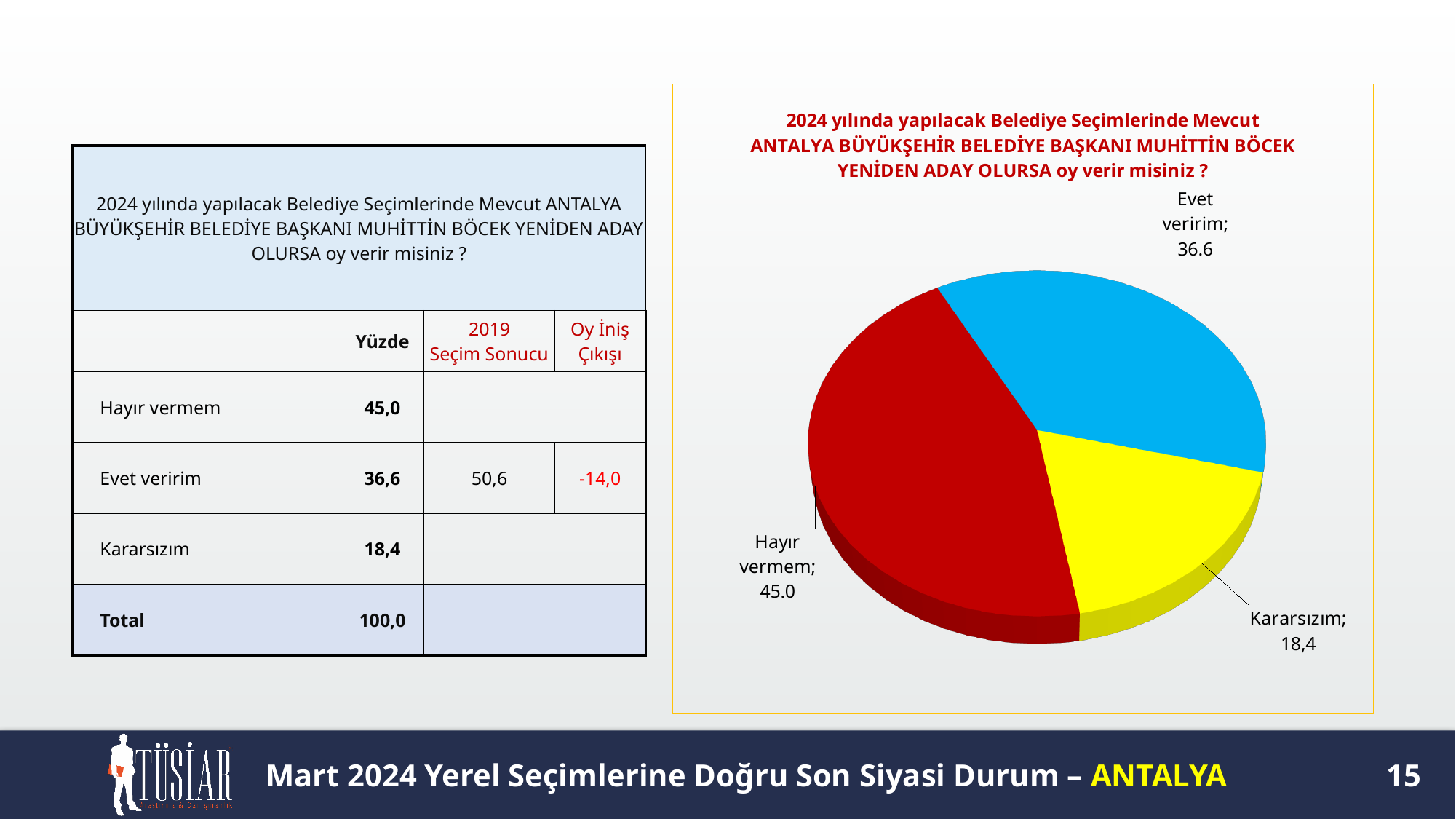
What kind of chart is shown on the slide? pie chart Which slice of the pie chart is the smallest? Kararsızım Which slice of the pie chart is the largest? Hayır vermem Which is larger in the pie chart, 'Evet veririm' or 'Hayır vermem'? Hayır vermem What is the value shown for the 'Evet veririm' slice in the pie chart? 36.6 What is the difference between the 'Hayır vermem' and 'Evet veririm' values in the pie chart? 8.4 What colour is the 'Hayır vermem' slice in the pie chart? red What is the value shown for the 'Kararsızım' slice in the pie chart? 18,4 Which is larger in the pie chart, 'Evet veririm' or 'Kararsızım'? Evet veririm How many slices does the pie chart have? 3 What is the value shown for the 'Hayır vermem' slice in the pie chart? 45.0 What colour is the 'Kararsızım' slice in the pie chart? yellow